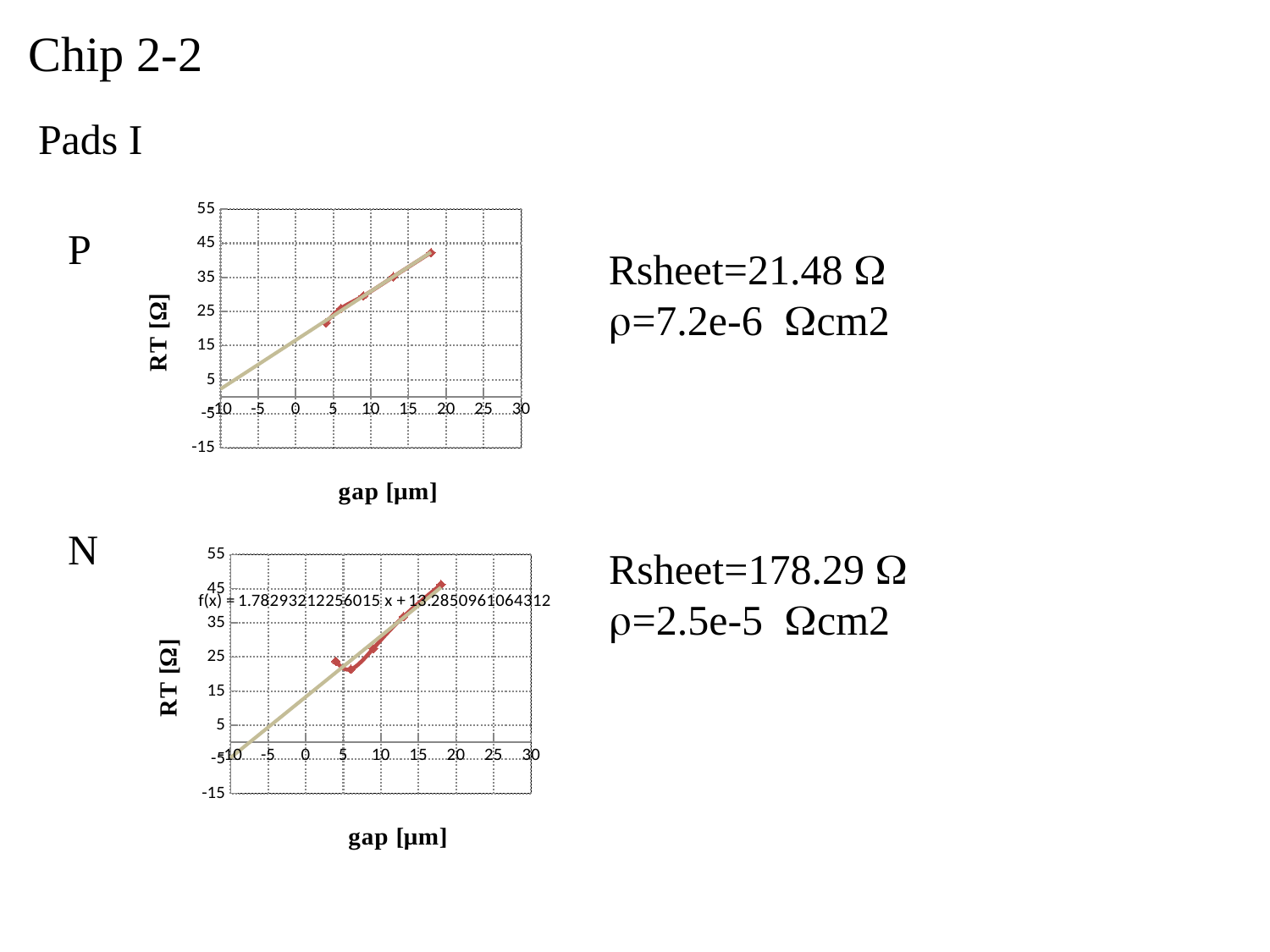
In the P chart (top), is the RT value at the largest gap (around 18 μm) greater or less than 35? greater In the P chart (top), is the RT value at a gap of about 5 μm greater or less than 35? less What is the intercept in the fitted line equation printed on the N chart (bottom)? 13.2850961064312 What is the y-axis title of the P chart (top)? RT [Ω] In the N chart (bottom), do the RT values rise or fall as gap increases? rise What is the slope in the fitted line equation printed on the N chart (bottom)? 1.78293212256015 In the P chart (top), do the RT values rise or fall as gap increases? rise What is the x-axis title of the N chart (bottom)? gap [μm] In the N chart (bottom), is the RT value at the largest gap (around 17 μm) greater or less than 35? greater What kind of chart is the P chart (top)? scatter chart with a trend line